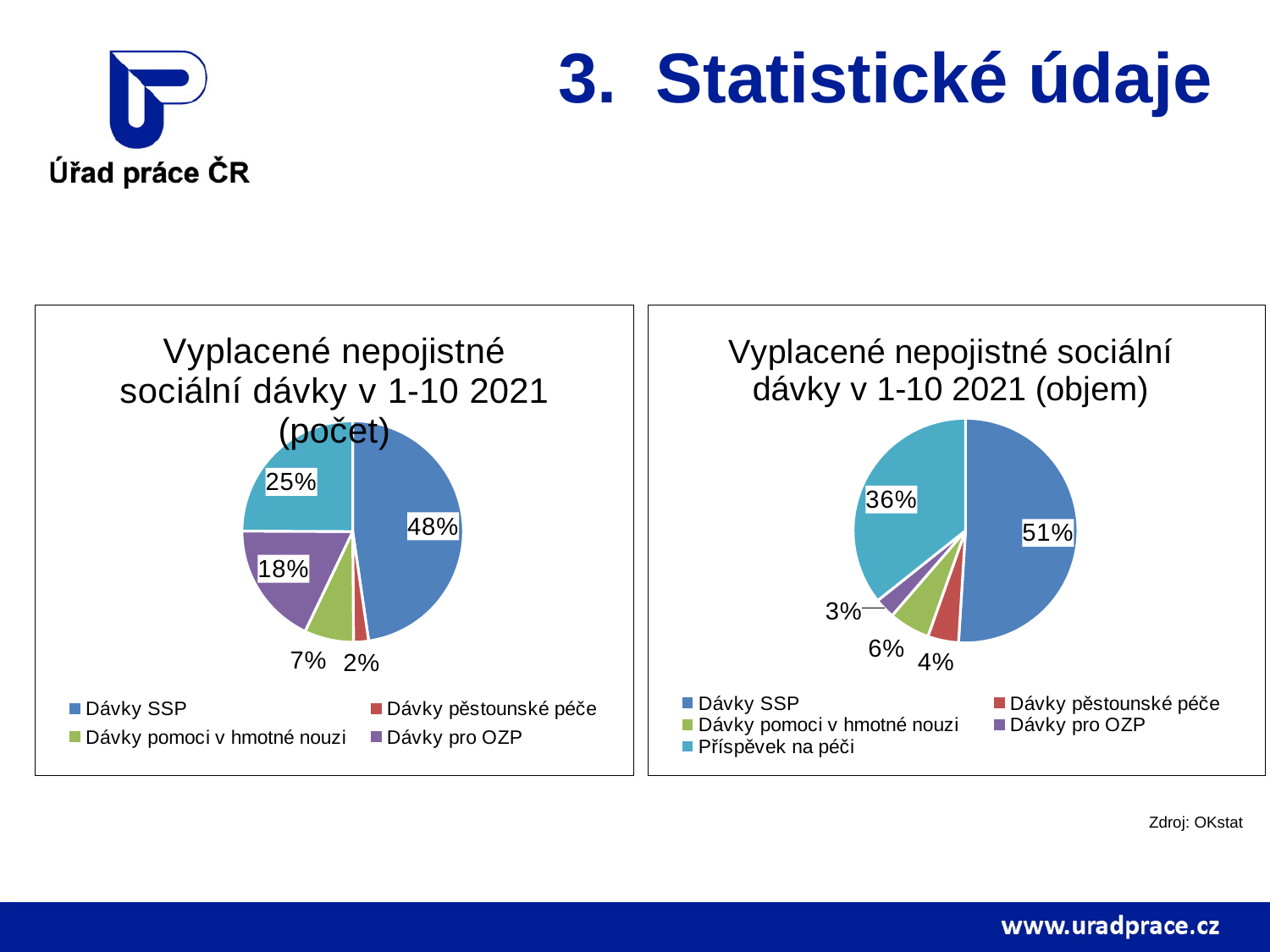
How many entries does the legend of the right chart (objem) list? 5 In the right chart (objem), which category has the smallest slice? Dávky pro OZP In the left chart (počet), what share is shown for Dávky SSP? 48% In the right chart (objem), what share is shown for Dávky pro OZP? 3% In the left chart (počet), which category has the largest slice? Dávky SSP In the left chart (počet), what share is shown for Dávky pro OZP? 18% In the left chart (počet), what share is shown for Dávky pěstounské péče? 2% In the right chart (objem), which is larger: Dávky pomoci v hmotné nouzi or Dávky pěstounské péče? Dávky pomoci v hmotné nouzi In the right chart (objem), what share is shown for Příspěvek na péči? 36% What kind of chart is the left chart titled "Vyplacené nepojistné sociální dávky v 1-10 2021 (počet)"? Pie chart In the left chart (počet), what is the difference between the shares of Dávky pro OZP and Dávky pomoci v hmotné nouzi? 11% In the right chart (objem), what is the combined share of Dávky SSP and Příspěvek na péči? 87%